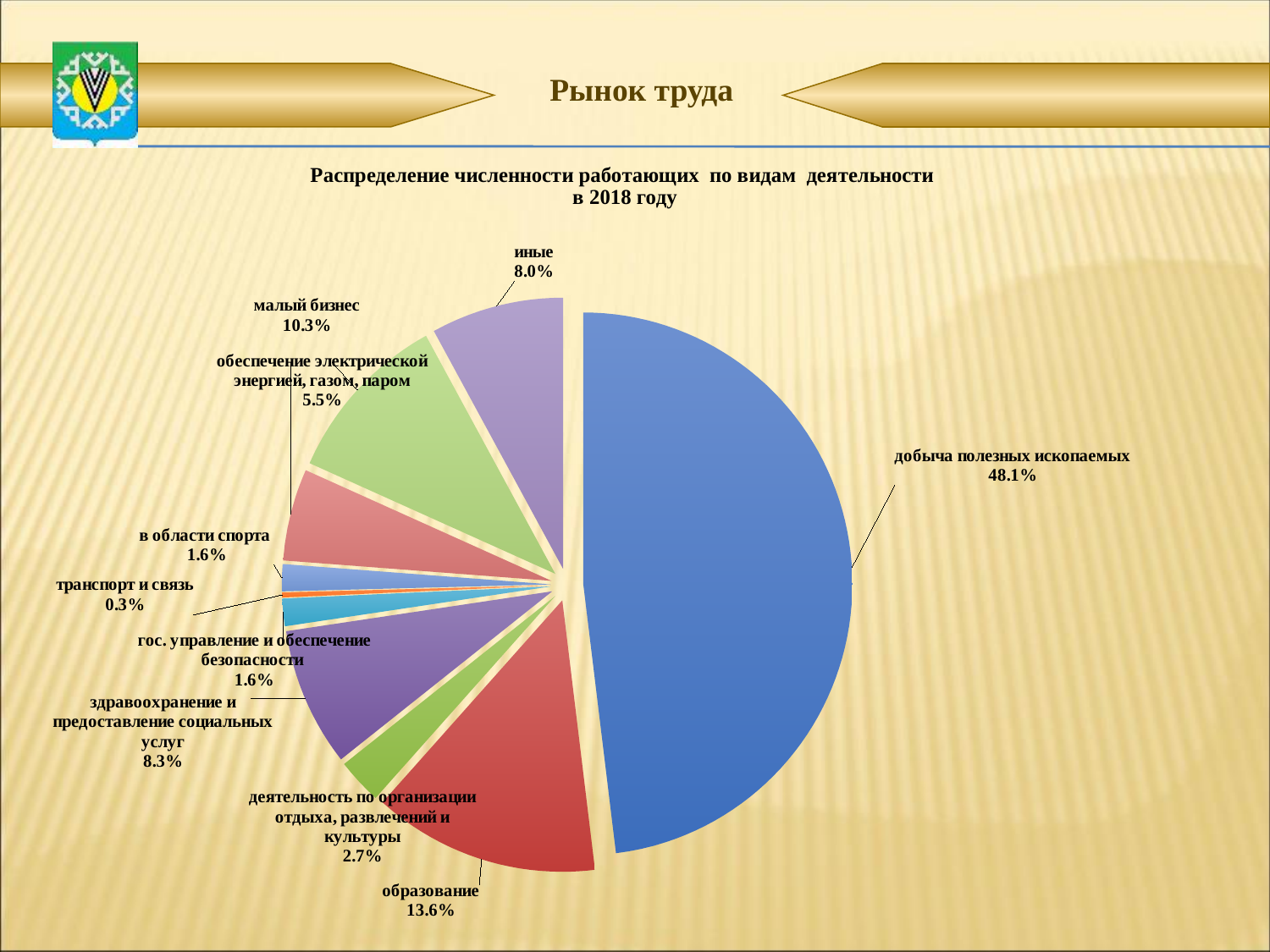
How many slices does the pie chart have? 10 What share of workers is in малый бизнес? 10.3% What is the title of the chart? Распределение численности работающих по видам деятельности в 2018 году What share of workers is in здравоохранение и предоставление социальных услуг? 8.3% What kind of chart is shown on the slide? pie chart What share of workers is in образование? 13.6% Which is larger, the share for малый бизнес or the share for иные? малый бизнес What is the difference between the shares for добыча полезных ископаемых and образование? 34.5% What is the share for обеспечение электрической энергией, газом, паром? 5.5% Which activity has the smallest share of workers? транспорт и связь Which activity has the largest share of workers? добыча полезных ископаемых What share of workers is in добыча полезных ископаемых? 48.1%